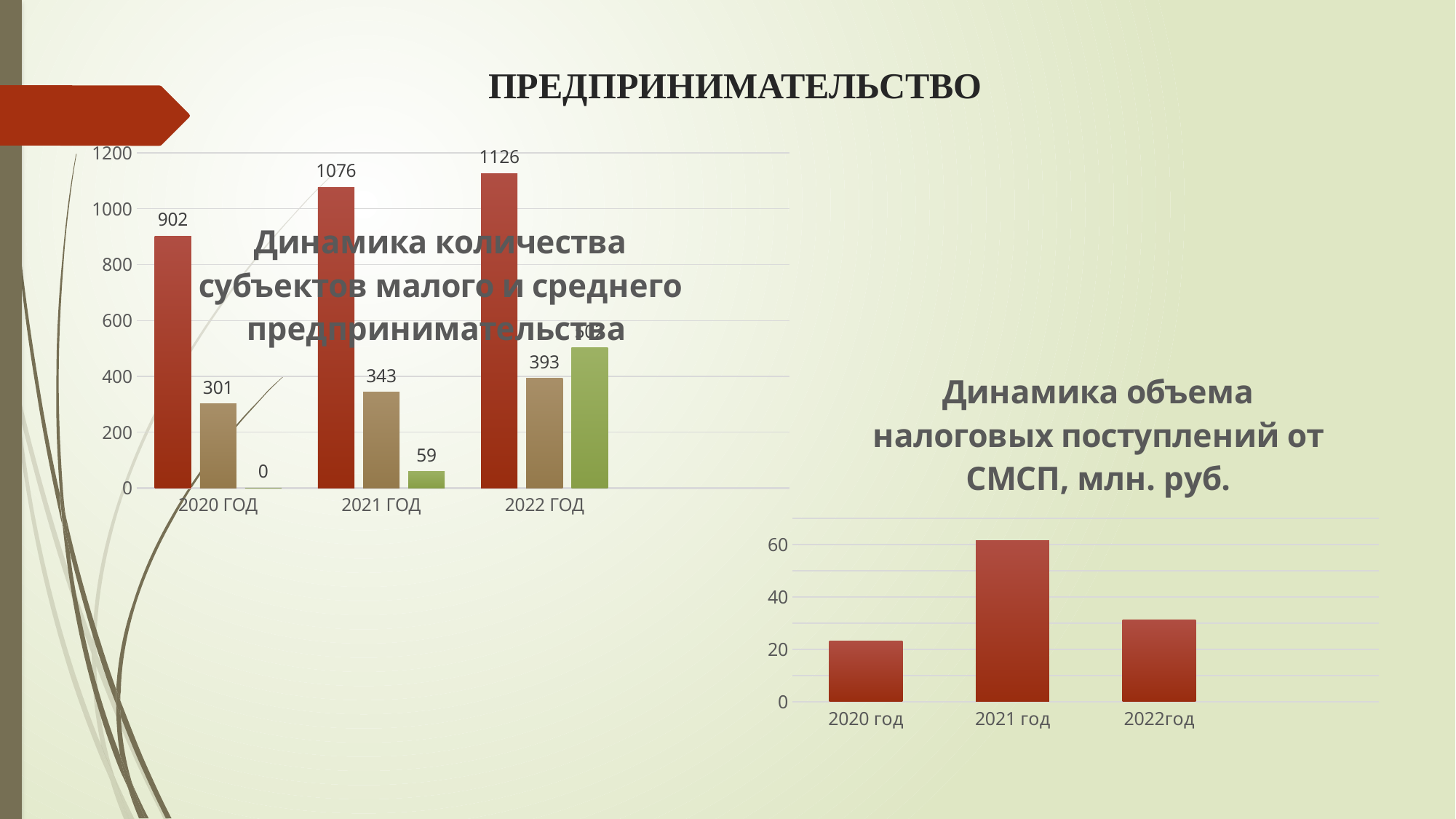
In the chart 'Динамика количества субъектов малого и среднего предпринимательства', do the red bar values rise or fall from 2020 ГОД to 2022 ГОД? rise In the chart 'Динамика количества субъектов малого и среднего предпринимательства', what is the difference between the red bar values for 2021 ГОД and 2020 ГОД? 174 What kind of chart is 'Динамика объема налоговых поступлений от СМСП, млн. руб.'? bar chart In the chart 'Динамика объема налоговых поступлений от СМСП, млн. руб.', which year has the highest bar? 2021 год In the chart 'Динамика количества субъектов малого и среднего предпринимательства', what is the value of the red bar for 2022 ГОД? 1126 In the chart 'Динамика количества субъектов малого и среднего предпринимательства', what is the difference between the brown bar values for 2022 ГОД and 2020 ГОД? 92 How many year categories are shown on the x axis of the chart 'Динамика количества субъектов малого и среднего предпринимательства'? 3 In the chart 'Динамика количества субъектов малого и среднего предпринимательства', what is the value of the green bar for 2021 ГОД? 59 In the chart 'Динамика количества субъектов малого и среднего предпринимательства', what is the value of the red bar for 2020 ГОД? 902 In the chart 'Динамика количества субъектов малого и среднего предпринимательства', in which year is the red bar highest? 2022 ГОД In the chart 'Динамика количества субъектов малого и среднего предпринимательства', what is the value of the brown bar for 2021 ГОД? 343